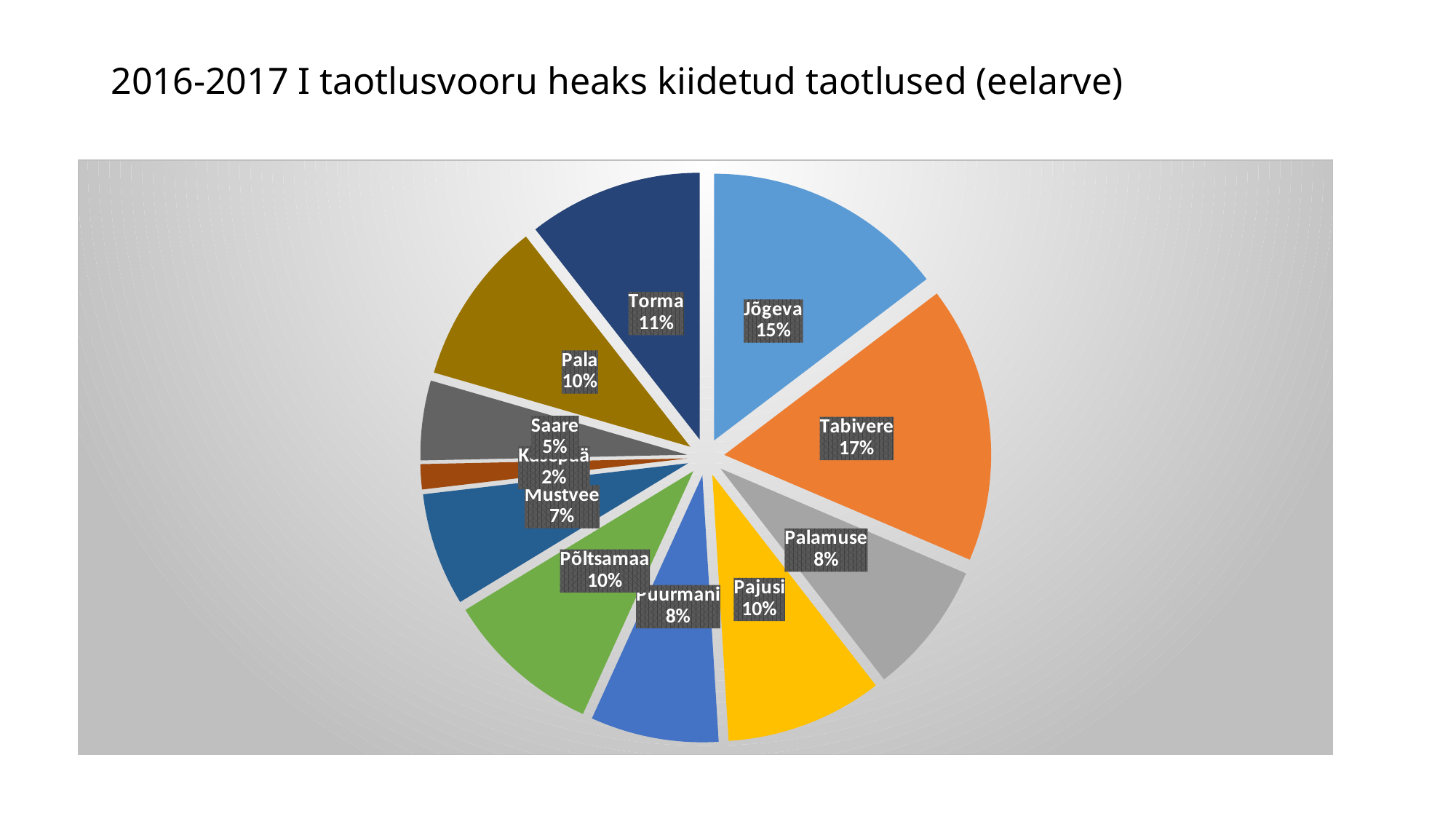
What percentage is shown for Saare? 5% What share of the pie does Jõgeva have? 15% What is the difference in percentage points between Pajusi and Puurmani? 2 Which is larger, the share for Torma or the share for Palamuse? Torma What is the title of the chart on the slide? 2016-2017 I taotlusvooru heaks kiidetud taotlused (eelarve) What percentage is shown for Torma? 11% What percentage is shown for Mustvee? 7% What type of chart is shown on the slide? pie chart Which slice has the largest share of the pie? Tabivere What is the difference in percentage points between Tabivere and Jõgeva? 2 What share of the pie does Tabivere have? 17% How many slices does the pie chart have? 11